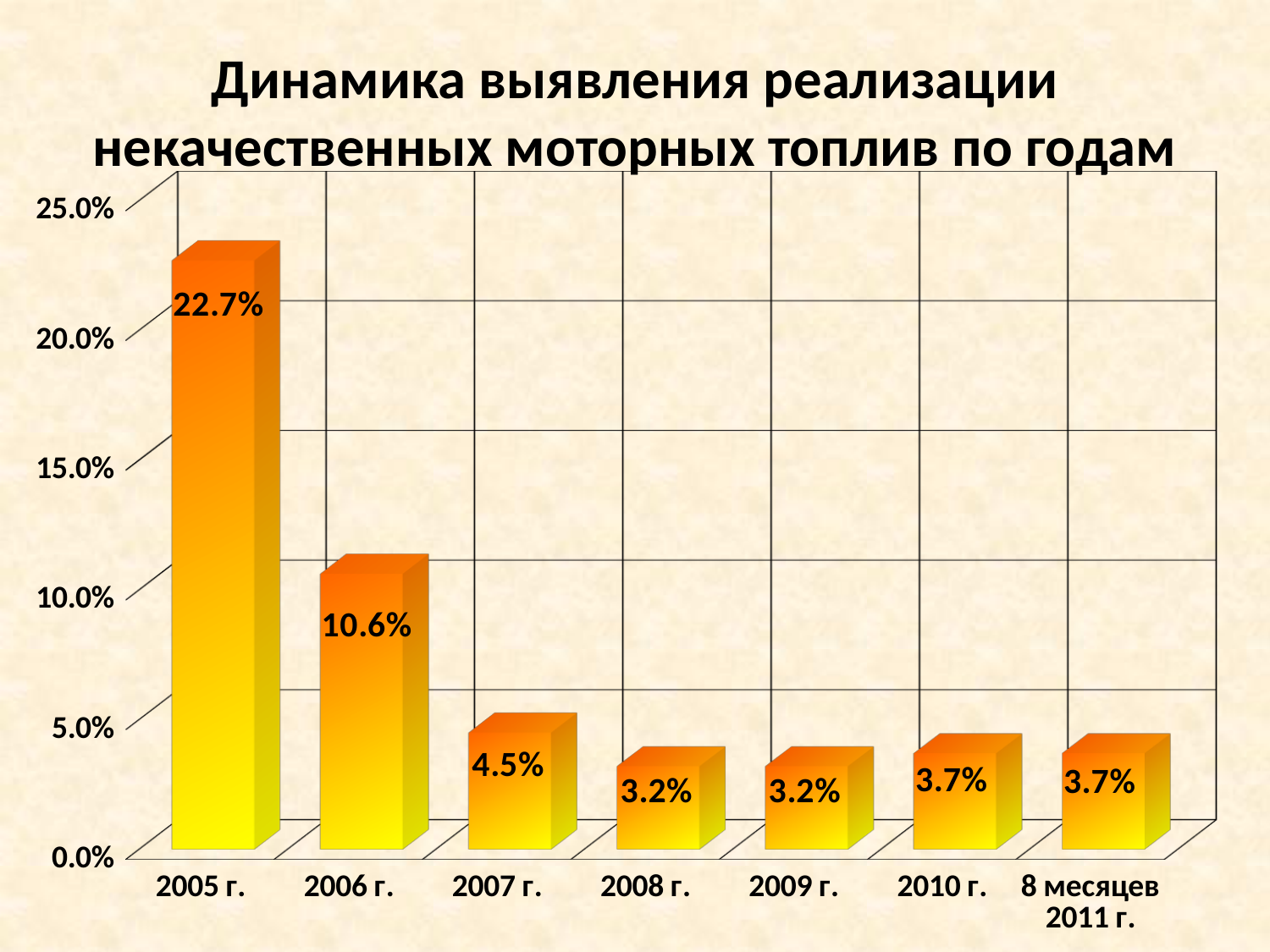
Is the value for 2006 г. greater or less than 10.0%? greater How many categories are shown on the x axis? 7 What is the value for 8 месяцев 2011 г.? 3.7% Which is larger, the value for 2006 г. or the value for 2010 г.? 2006 г. What kind of chart is shown on the slide? Bar chart What is the difference between the values for 2007 г. and 2008 г.? 1.3% What is the value for 2007 г.? 4.5% Which year has the highest value? 2005 г. What is the value for 2005 г.? 22.7% What is the difference between the values for 2005 г. and 2006 г.? 12.1% Do the values generally rise or fall from 2005 г. to 2009 г.? Fall What is the value for 2006 г.? 10.6%